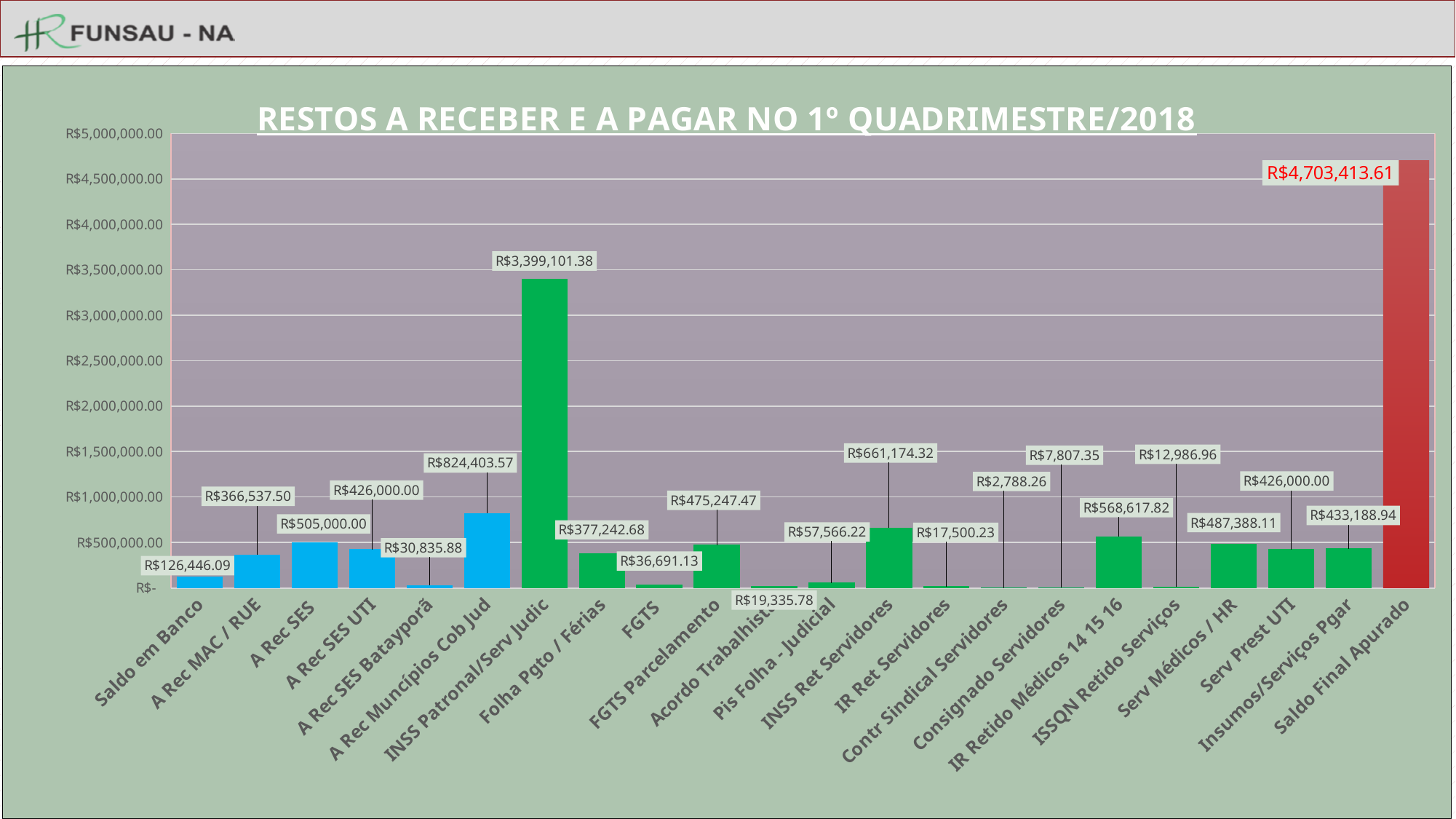
Is the value for INSS Patronal/Serv Judic greater or less than R$3,000,000.00? greater What is the value for IR Retido Médicos 14 15 16? R$568,617.82 Which is larger, INSS Ret Servidores or FGTS Parcelamento? INSS Ret Servidores What is the value for INSS Patronal/Serv Judic? R$3,399,101.38 What type of chart is shown? Bar chart How many categories are shown on the x axis? 22 What is the value for A Rec Muncípios Cob Jud? R$824,403.57 What is the difference between A Rec SES and A Rec SES UTI? R$79,000.00 Which category has the highest value? Saldo Final Apurado What is the value for Saldo Final Apurado? R$4,703,413.61 What is the difference between Saldo Final Apurado and INSS Patronal/Serv Judic? R$1,304,312.23 Which category has the lowest value? Contr Sindical Servidores